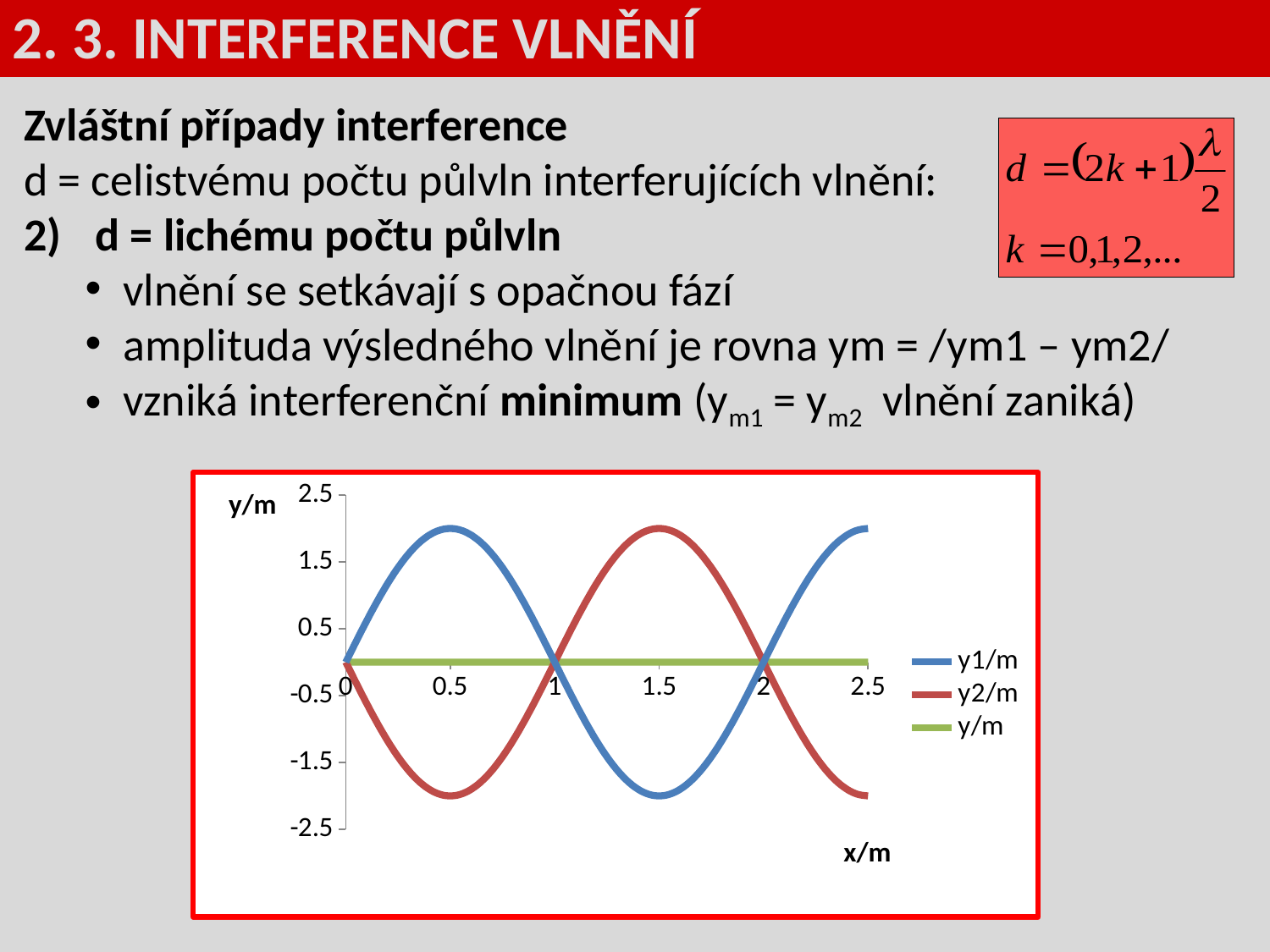
Is the value of y2/m at x = 1.5 greater or less than 1.5? greater At x = 1.5, which series has the larger value, y1/m or y2/m? y2/m Does the y2/m series rise or fall as x goes from 0 to 0.5? fall Does the y1/m series rise or fall as x goes from 0 to 0.5? rise What colour is the y2/m series in the chart? red What are the three series named in the chart legend? y1/m, y2/m, y/m What kind of chart is shown on the slide? line chart At x = 0.5, which series has the larger value, y1/m or y2/m? y1/m How many series does the chart legend list? 3 Is the value of y1/m at x = 1.5 greater or less than -1.5? less Is the value of y2/m at x = 0.5 greater or less than -1.5? less